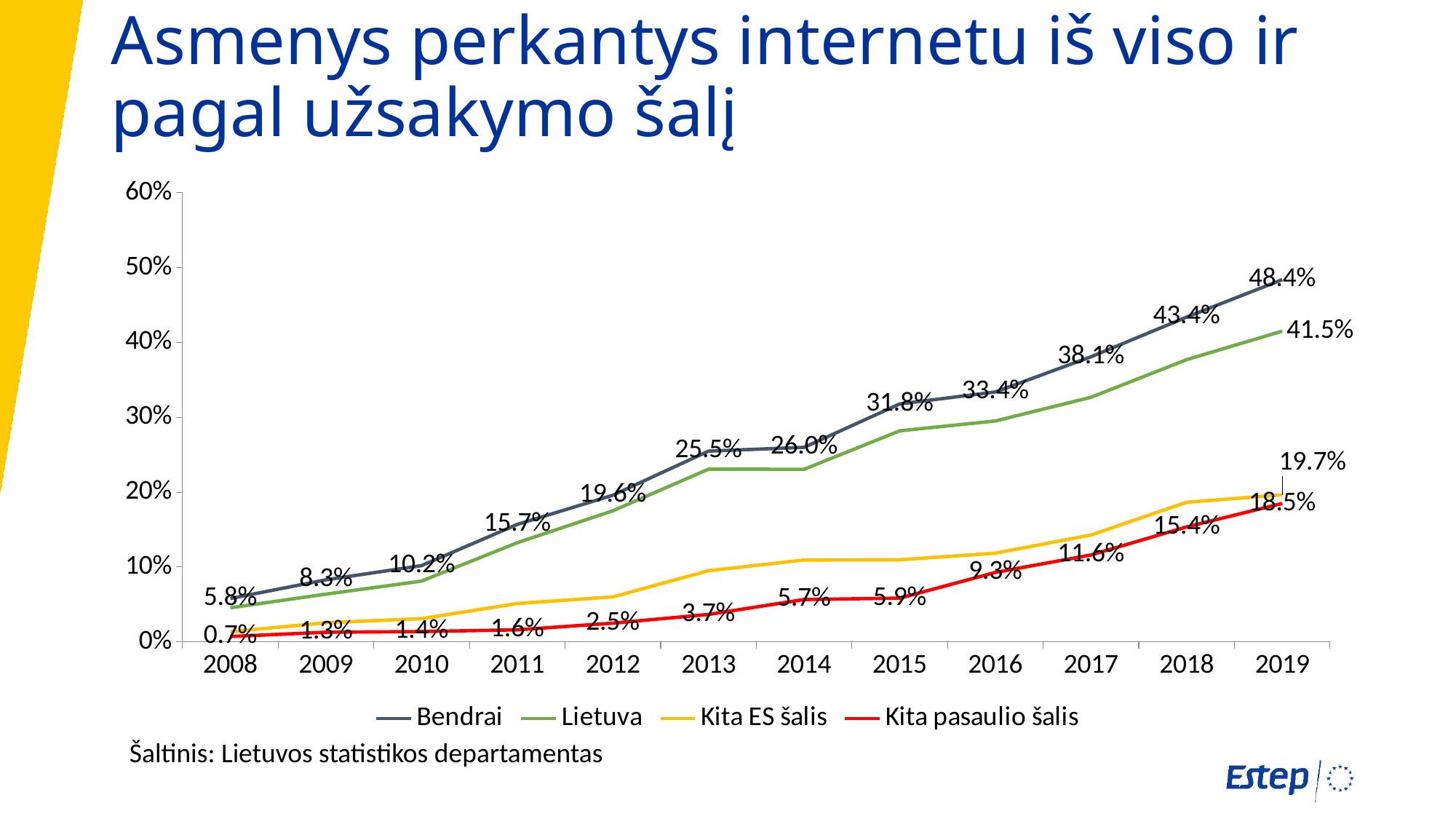
What is the value for Lietuva in 2019? 41.5% What is the value for Kita pasaulio šalis in 2008? 0.7% In which year is the Kita pasaulio šalis series at its lowest? 2008 How many years are shown on the x axis? 12 How many series does the legend list? 4 What is the value for Bendrai in 2019? 48.4% In which year is the Bendrai series at its highest? 2019 Which is larger in 2019: Kita ES šalis or Kita pasaulio šalis? Kita ES šalis Is the value for Lietuva in 2015 greater or less than 20%? greater What is the value for Kita ES šalis in 2019? 19.7% What is the difference between the Bendrai values in 2019 and 2018? 5.0% What kind of chart is shown on the slide? line chart